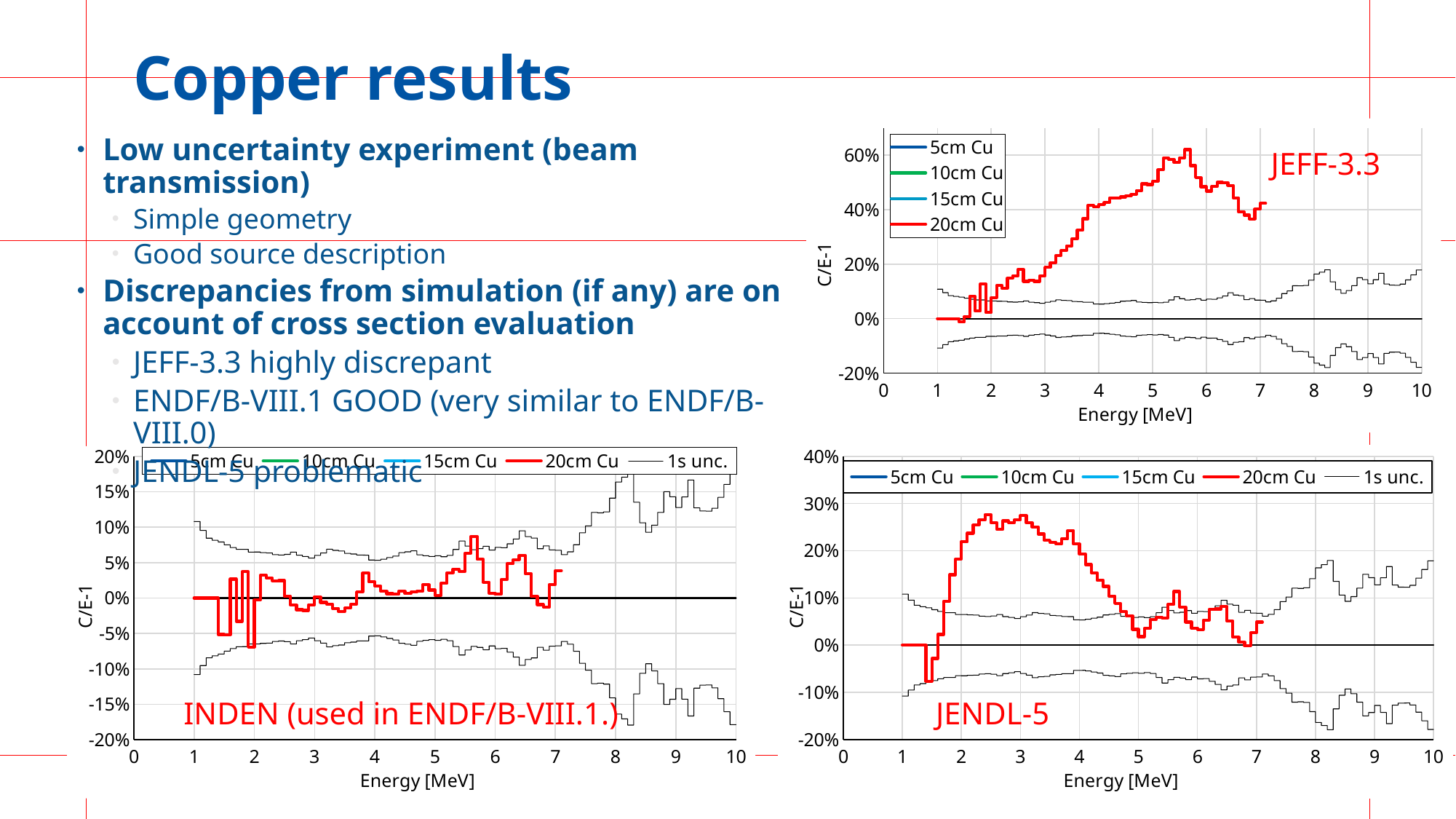
In the INDEN chart at the bottom left, how many entries does the legend list? 5 In the INDEN chart, is the value of the 20cm Cu line at 1.5 MeV greater or less than 0%? less How many charts are shown on the slide? 3 In the JEFF-3.3 chart, what is the label of the x axis? Energy [MeV] In the JEFF-3.3 chart, how many series does the legend list? 4 In the JENDL-5 chart, is the peak value of the 20cm Cu line near 2.5 MeV greater or less than 20%? greater In the JEFF-3.3 chart, is the value of the 20cm Cu line at 5 MeV greater or less than 40%? greater What kind of chart is the JEFF-3.3 chart in the top right? line chart In the JENDL-5 chart, what is the label of the y axis? C/E-1 Which chart shows the higher peak value of the 20cm Cu line, JEFF-3.3 or JENDL-5? JEFF-3.3 In the JEFF-3.3 chart, does the 20cm Cu line rise or fall between 1 MeV and 5 MeV? rise